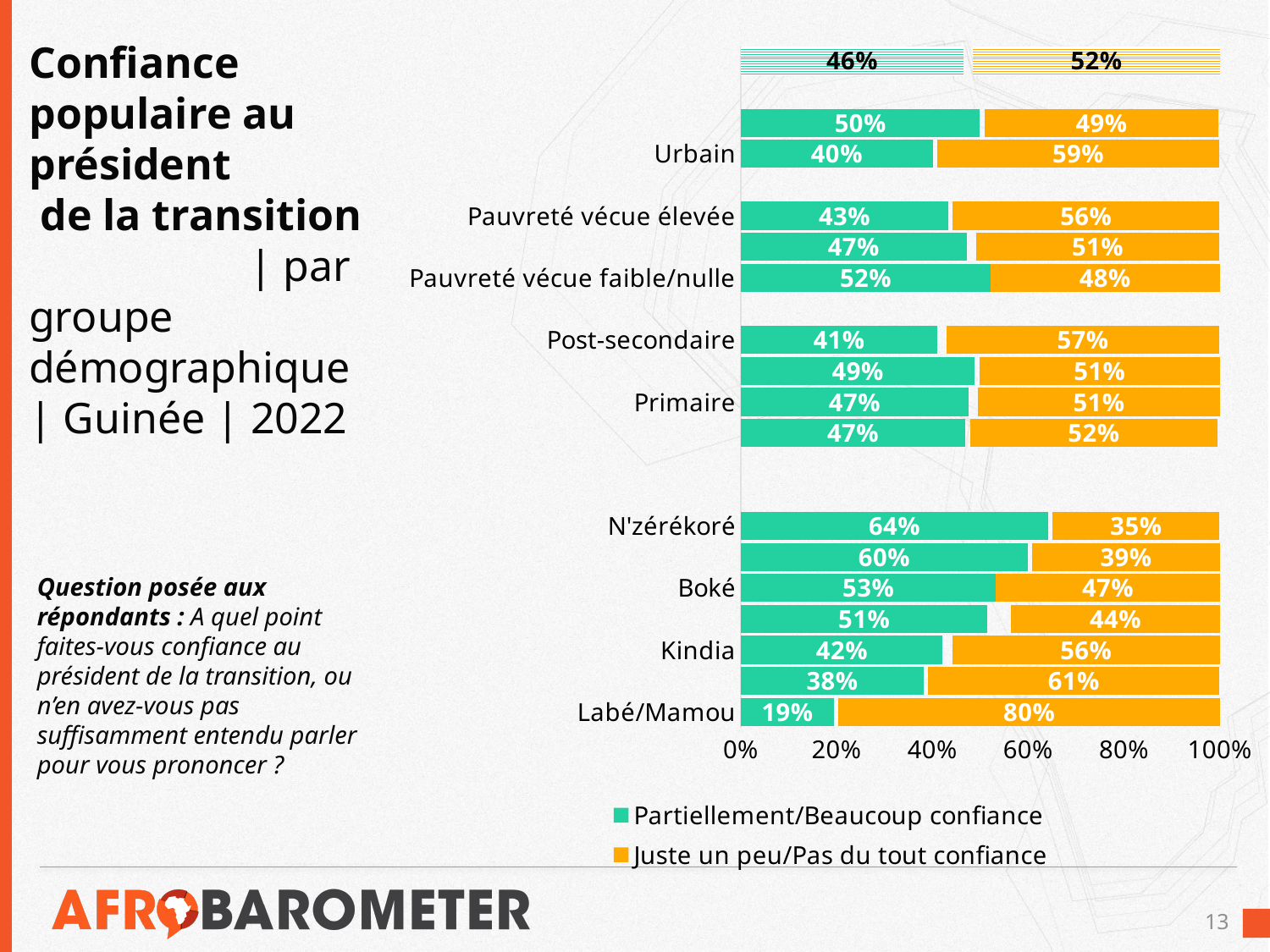
Among the labelled regions (N'zérékoré, Boké, Kindia, Labé/Mamou), which has the highest 'Partiellement/Beaucoup confiance' value? N'zérékoré What is the 'Partiellement/Beaucoup confiance' value for Urbain? 40% Is the 'Juste un peu/Pas du tout confiance' value for Labé/Mamou greater or less than 60%? greater What kind of chart is shown on the slide? Stacked bar chart Among the labelled categories, which has the lowest 'Partiellement/Beaucoup confiance' value? Labé/Mamou Which has a higher 'Partiellement/Beaucoup confiance' value: Pauvreté vécue élevée or Pauvreté vécue faible/nulle? Pauvreté vécue faible/nulle Which colour represents 'Juste un peu/Pas du tout confiance' in the chart? Orange What is the 'Juste un peu/Pas du tout confiance' value for N'zérékoré? 35% What percentage of respondents in Labé/Mamou have 'Partiellement/Beaucoup confiance' in the transition president? 19% What is the difference between the 'Juste un peu/Pas du tout confiance' values for Labé/Mamou and Kindia? 24 percentage points How many series does the legend list? 2 What is the total of the two labelled segments for the Boké bar? 100%